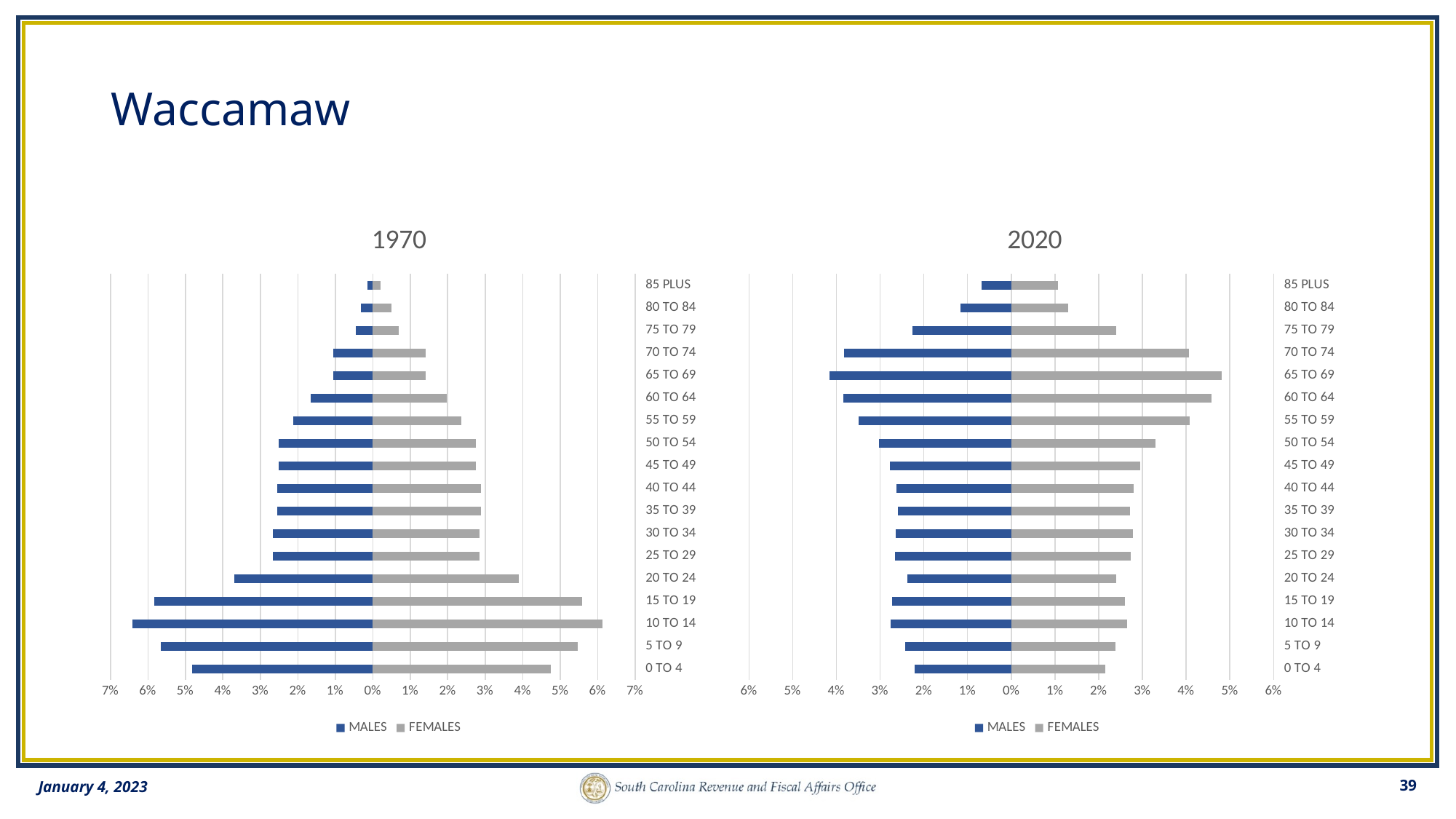
In the 1970 chart, is the MALES value for 10 TO 14 greater or less than 6%? greater How many series does the legend of the 2020 chart list? 2 In the 1970 chart, which age group has the highest value for MALES? 10 TO 14 In the 1970 chart, is the MALES value for 20 TO 24 greater or less than 4%? less In the 2020 chart, is the MALES value for 85 PLUS greater or less than 1%? less Is the MALES value for 10 TO 14 larger in the 1970 chart or the 2020 chart? 1970 In the 2020 chart, which age group has the lowest value for MALES? 85 PLUS What kind of chart is the 1970 chart? bar chart In the 1970 chart, which age group has the lowest value for FEMALES? 85 PLUS In the 2020 chart, which colour represents FEMALES? gray In the 2020 chart, which age group has the highest value for FEMALES? 65 TO 69 How many age groups are shown on the 1970 chart? 18